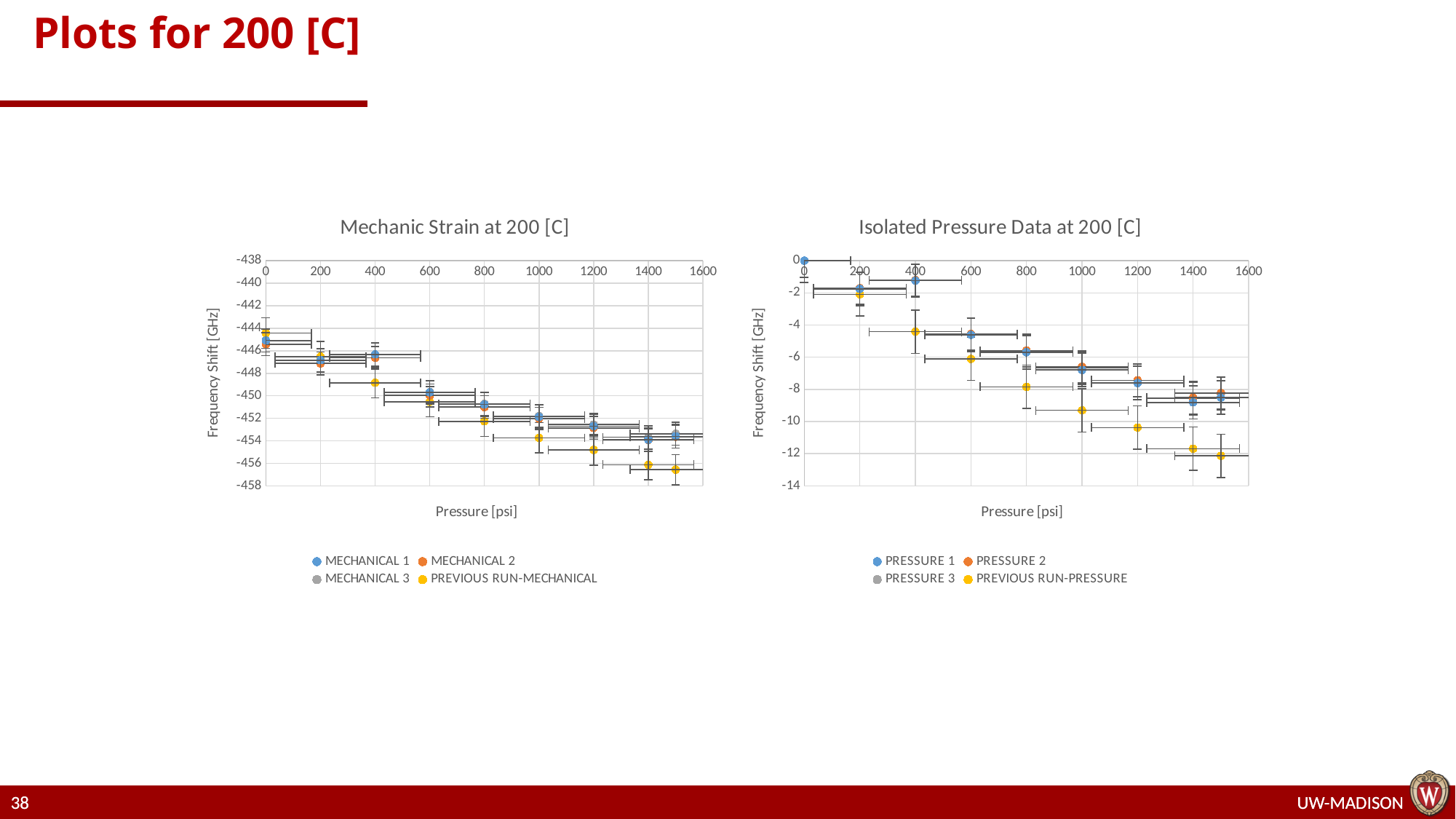
In the 'Isolated Pressure Data at 200 [C]' chart, do the frequency shift values rise or fall as pressure increases? Fall How many series does the legend of the 'Mechanic Strain at 200 [C]' chart list? 4 In the 'Mechanic Strain at 200 [C]' chart, is the value for PREVIOUS RUN-MECHANICAL at 1000 psi greater or less than -452? less What is the y-axis label of the 'Mechanic Strain at 200 [C]' chart? Frequency Shift [GHz] In the 'Isolated Pressure Data at 200 [C]' chart, is the value for PREVIOUS RUN-PRESSURE at 1500 psi greater or less than -10? less What kind of chart is the 'Mechanic Strain at 200 [C]' chart? Scatter chart In the 'Isolated Pressure Data at 200 [C]' chart, is the value for PRESSURE 1 at 1000 psi greater or less than -8? greater How many series does the legend of the 'Isolated Pressure Data at 200 [C]' chart list? 4 In the 'Isolated Pressure Data at 200 [C]' chart, at 1400 psi, which series has the higher frequency shift: PRESSURE 1 or PREVIOUS RUN-PRESSURE? PRESSURE 1 In the 'Mechanic Strain at 200 [C]' chart, do the frequency shift values rise or fall as pressure increases? Fall In the 'Mechanic Strain at 200 [C]' chart, at 1500 psi, which series has the higher frequency shift: MECHANICAL 1 or PREVIOUS RUN-MECHANICAL? MECHANICAL 1 In the 'Isolated Pressure Data at 200 [C]' chart, what is the frequency shift for PRESSURE 1 at 0 psi? 0